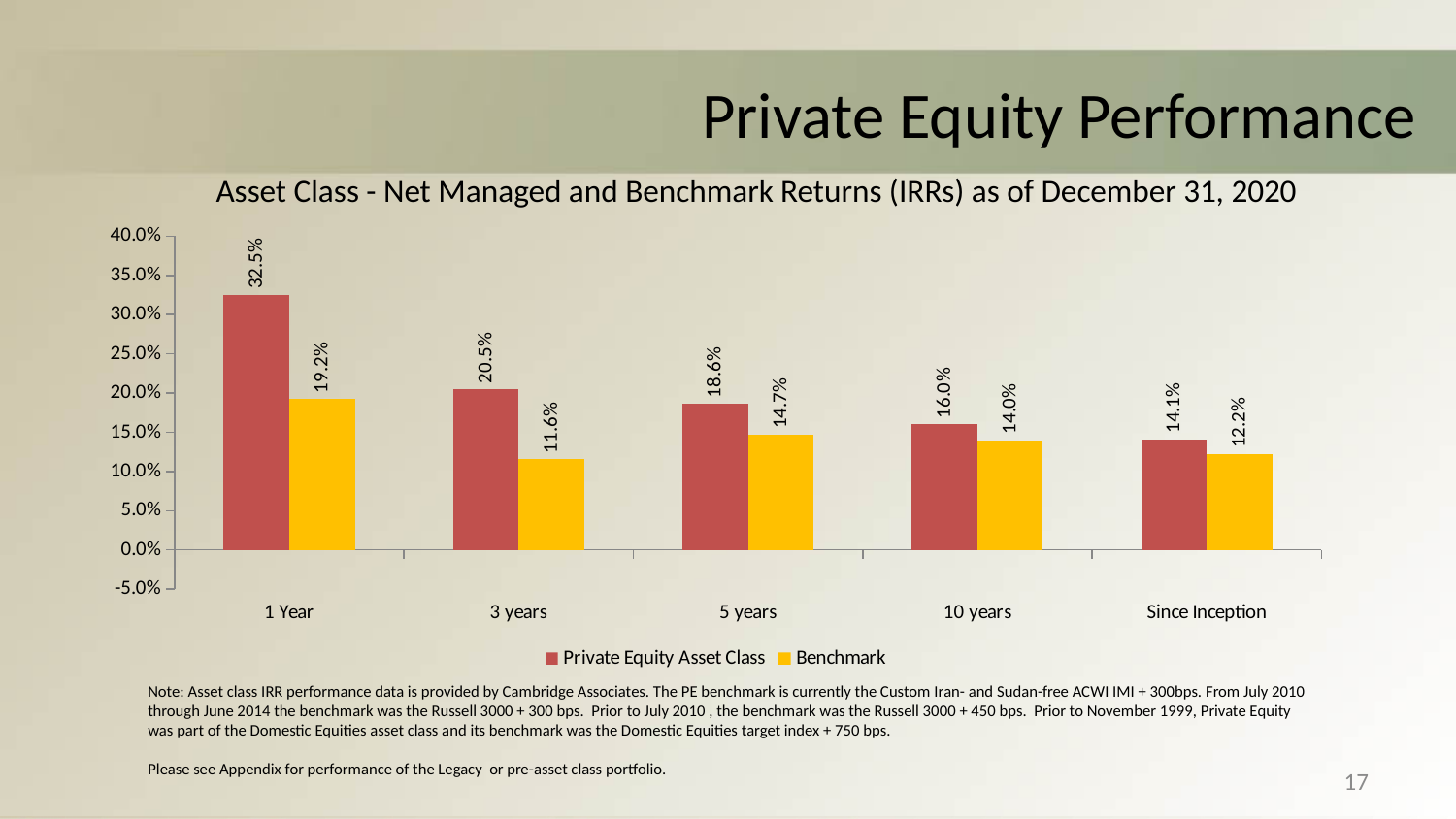
Which period has the highest Private Equity Asset Class return? 1 Year Which period has the lowest Benchmark return? 3 years What is the difference between the Private Equity Asset Class and Benchmark returns for 10 years? 2.0% How many series does the legend list? 2 What is the difference between the Private Equity Asset Class and Benchmark returns for 1 Year? 13.3% How many time periods are shown on the x axis? 5 What kind of chart is shown on the slide? Bar chart Which is larger for 5 years: the Private Equity Asset Class return or the Benchmark return? Private Equity Asset Class What is the Benchmark return for 3 years? 11.6% What is the Private Equity Asset Class return for 1 Year? 32.5% Do the Private Equity Asset Class returns rise or fall from 1 Year to Since Inception? Fall What is the Private Equity Asset Class return for Since Inception? 14.1%